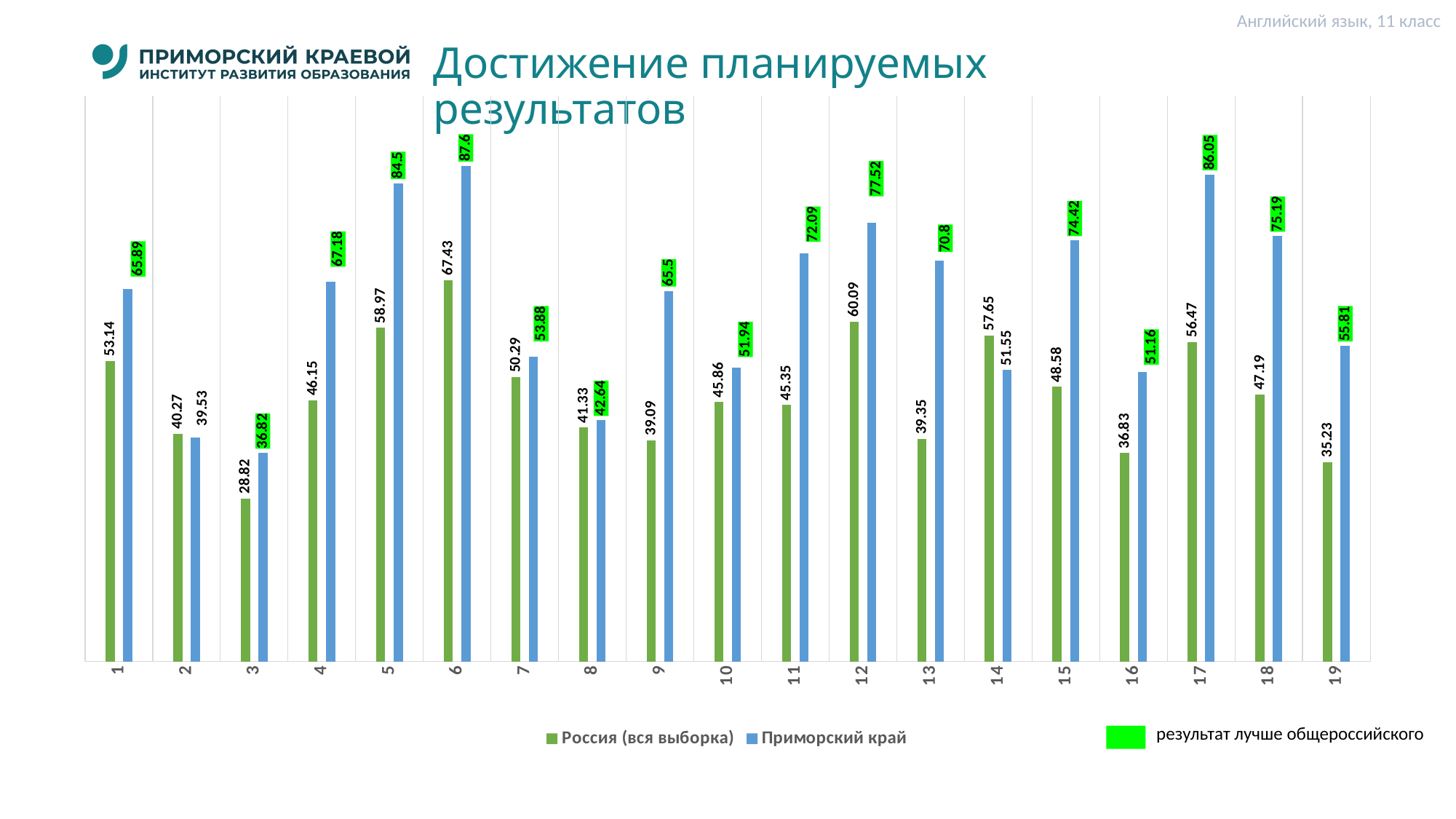
What is the value for Россия (вся выборка) for category 14? 57.65 How many categories are shown on the x axis? 19 Which category has the lowest value for Россия (вся выборка)? 3 What is the value for Россия (вся выборка) for category 3? 28.82 What kind of chart is shown on the slide? Bar chart Which category has the highest value for Приморский край? 6 What is the difference between the Приморский край and Россия (вся выборка) values for category 5? 25.53 What is the value for Приморский край for category 13? 70.8 How many series does the legend list? 2 What is the value for Приморский край for category 6? 87.6 Which series is shown in blue? Приморский край For category 14, which series has the larger value: Россия (вся выборка) or Приморский край? Россия (вся выборка)